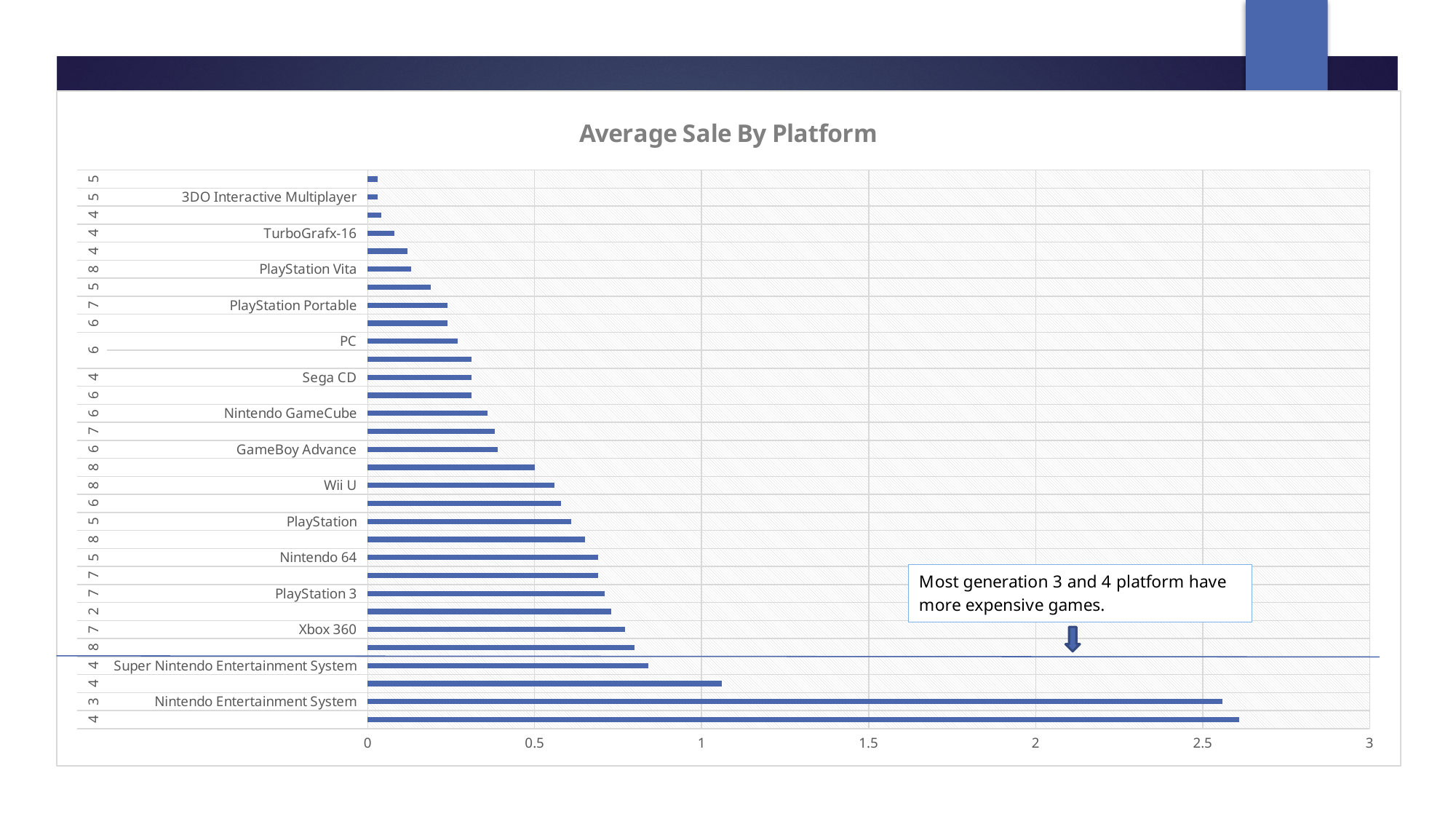
Do the bar lengths increase or decrease from the top of the chart to the bottom? increase Is the value for Super Nintendo Entertainment System greater or less than 1? less Is the value for GameBoy Advance greater or less than 0.5? less Which has the larger value, TurboGrafx-16 or 3DO Interactive Multiplayer? TurboGrafx-16 Is the value for Nintendo Entertainment System greater or less than 2? greater Which has the larger value, Xbox 360 or PC? Xbox 360 What kind of chart is shown on the slide? bar chart Which has the larger value, Nintendo Entertainment System or Super Nintendo Entertainment System? Nintendo Entertainment System What does the text box on the chart say? Most generation 3 and 4 platform have more expensive games. What is the title of the chart? Average Sale By Platform